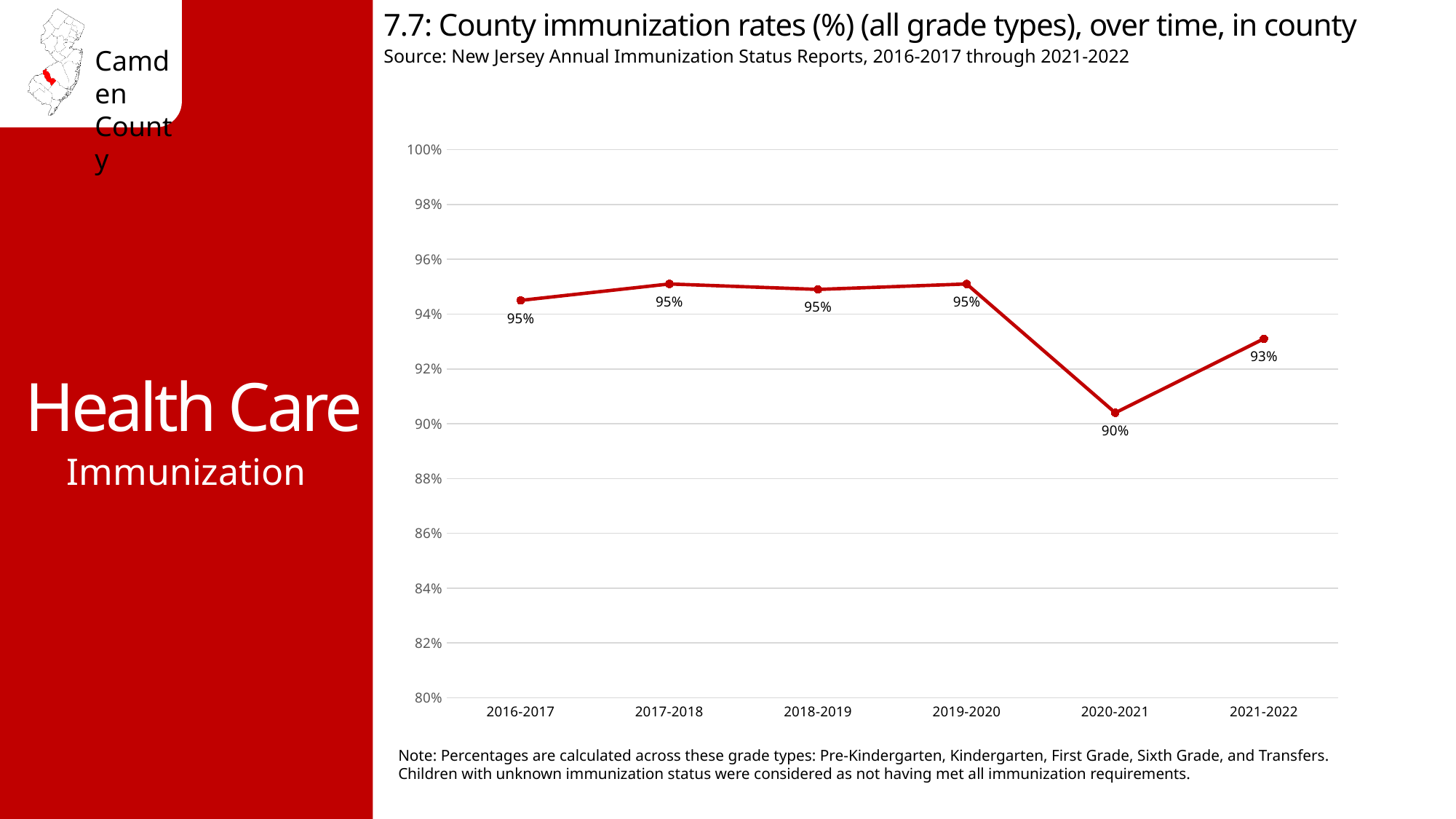
What is the county immunization rate for 2021-2022? 93% What is the difference in percentage points between the 2021-2022 rate and the 2020-2021 rate? 3 percentage points What type of chart is shown on the slide? Line chart How many school years are plotted on the chart? 6 Is the value for 2020-2021 greater or less than 92%? less What is the county immunization rate for 2016-2017? 95% What is the county immunization rate for 2020-2021? 90% Which school year has the lowest immunization rate? 2020-2021 What is the source cited for the chart data? New Jersey Annual Immunization Status Reports, 2016-2017 through 2021-2022 What is the difference in percentage points between the 2019-2020 rate and the 2020-2021 rate? 5 percentage points Which is larger, the immunization rate for 2020-2021 or for 2021-2022? 2021-2022 Does the immunization rate rise or fall from 2019-2020 to 2020-2021? Fall